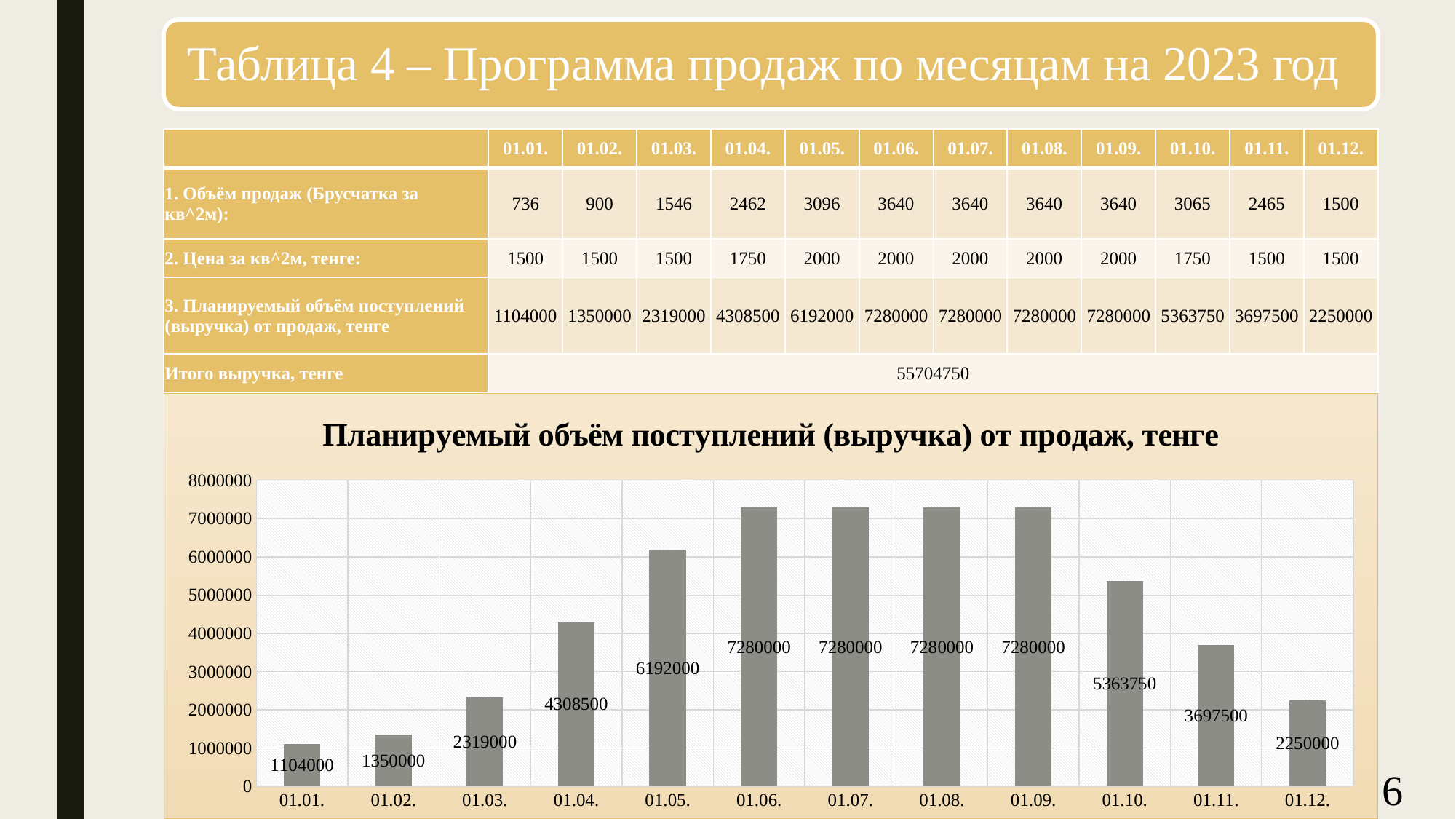
What type of chart is shown on the slide? Bar chart Do the values rise or fall from 01.09. to 01.12.? fall Is the value for 01.04. greater or less than 4000000? greater What is the value for 01.10. on the chart? 5363750 How many months (categories) are plotted on the chart? 12 What is the highest value shown on the chart? 7280000 What is the value for 01.12. on the chart? 2250000 Which month has the lowest value on the chart? 01.01. Which is larger, the value for 01.04. or the value for 01.11.? 01.04. What is the title of the chart? Планируемый объём поступлений (выручка) от продаж, тенге What is the value for 01.05. on the chart? 6192000 What is the difference between the values for 01.10. and 01.11.? 1666250